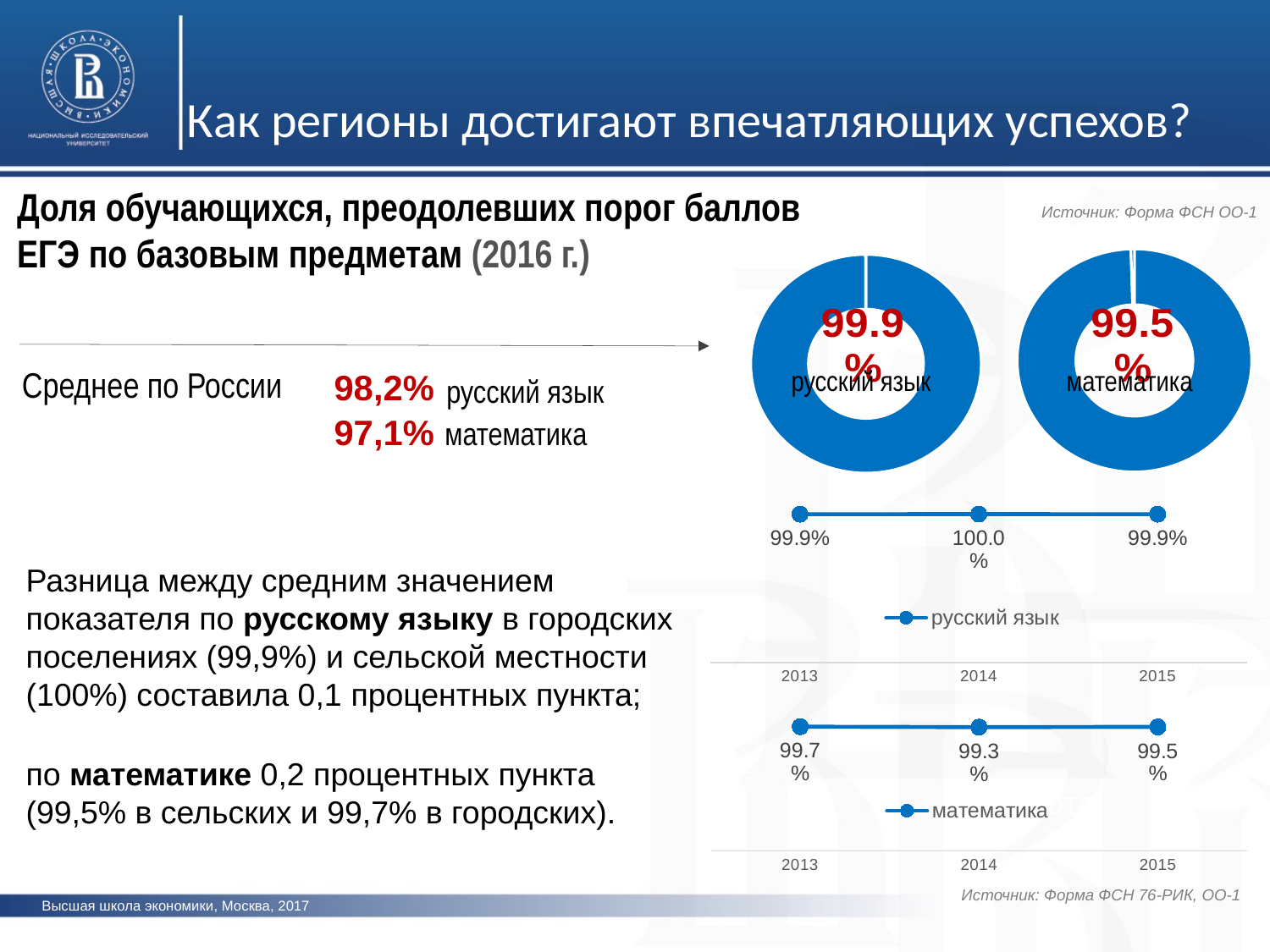
In the donut chart labelled 'русский язык' at the top right, what value is shown? 99.9% In the line chart for 'математика', which year has the highest value? 2013 In the line chart for 'математика', what is the value for 2014? 99.3% What type of chart is used for the two 'русский язык' and 'математика' charts at the top right of the slide? Donut chart In the line chart for 'математика', what is the difference between the 2013 and 2014 values? 0.4% In the line chart for 'русский язык', what is the value for 2014? 100.0% In the line chart for 'математика', what is the value for 2015? 99.5% What type of chart is used to show 'математика' values for 2013–2015 at the bottom right? Line chart In the donut chart labelled 'математика' at the top right, what value is shown? 99.5% How many data points are plotted in the line chart for 'русский язык'? 3 In the line chart for 'математика', which year has the lowest value? 2014 In the line chart for 'русский язык', what is the value for 2013? 99.9%